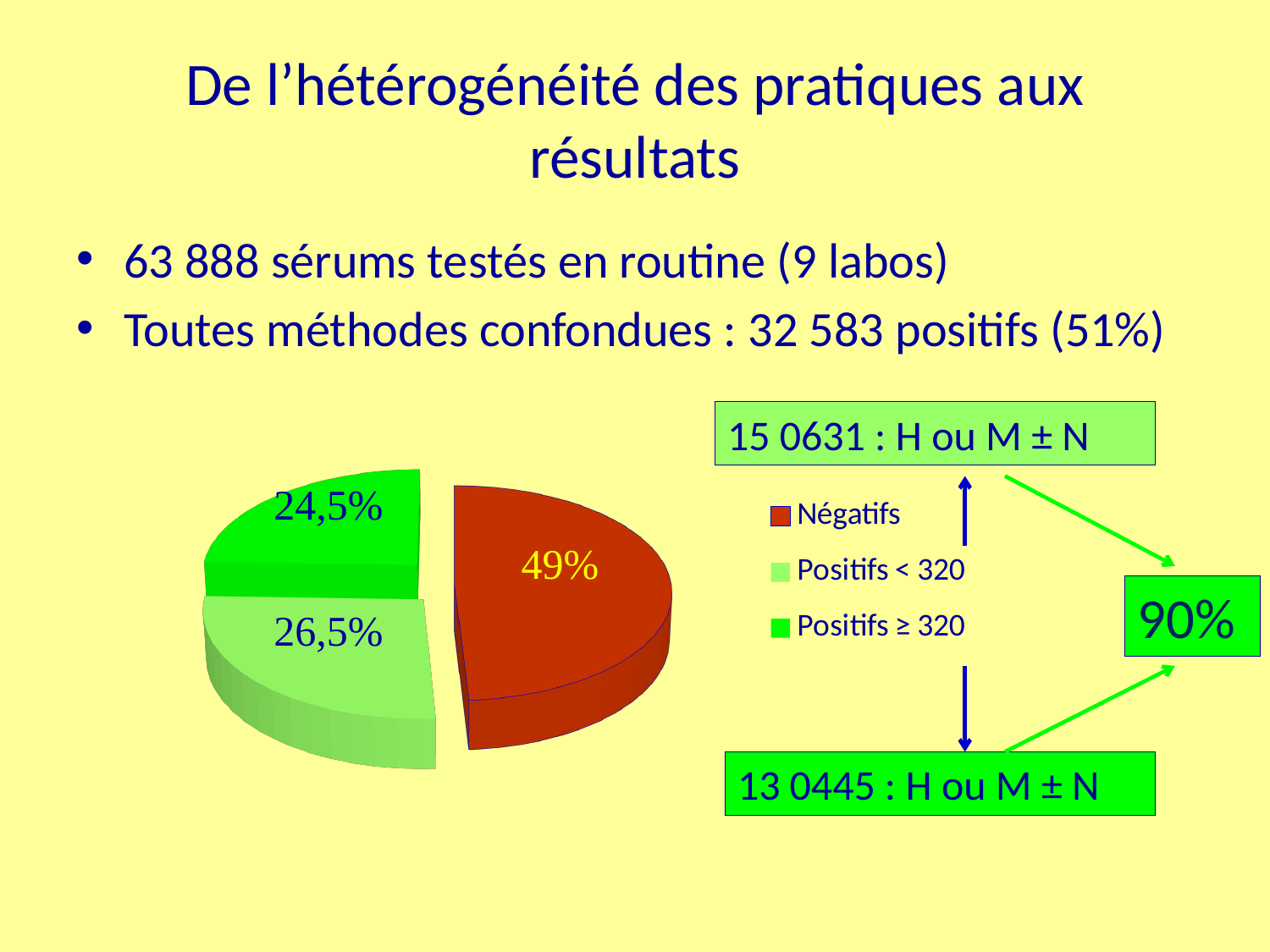
What is the difference between the Positifs < 320 slice and the Positifs ≥ 320 slice? 2% How many entries does the pie chart legend list? 3 What share of the pie chart is labelled Négatifs? 49% Which category has the largest slice in the pie chart? Négatifs What share of the pie chart corresponds to Positifs ≥ 320? 24,5% What colour is the Négatifs slice in the pie chart? red What is the difference between the Négatifs slice and the Positifs < 320 slice? 22,5% How many slices does the pie chart have? 3 What share of the pie chart corresponds to Positifs < 320? 26,5% Which category has the smallest slice in the pie chart? Positifs ≥ 320 What type of chart is shown on the slide? pie chart Which slice is larger: Positifs < 320 or Positifs ≥ 320? Positifs < 320